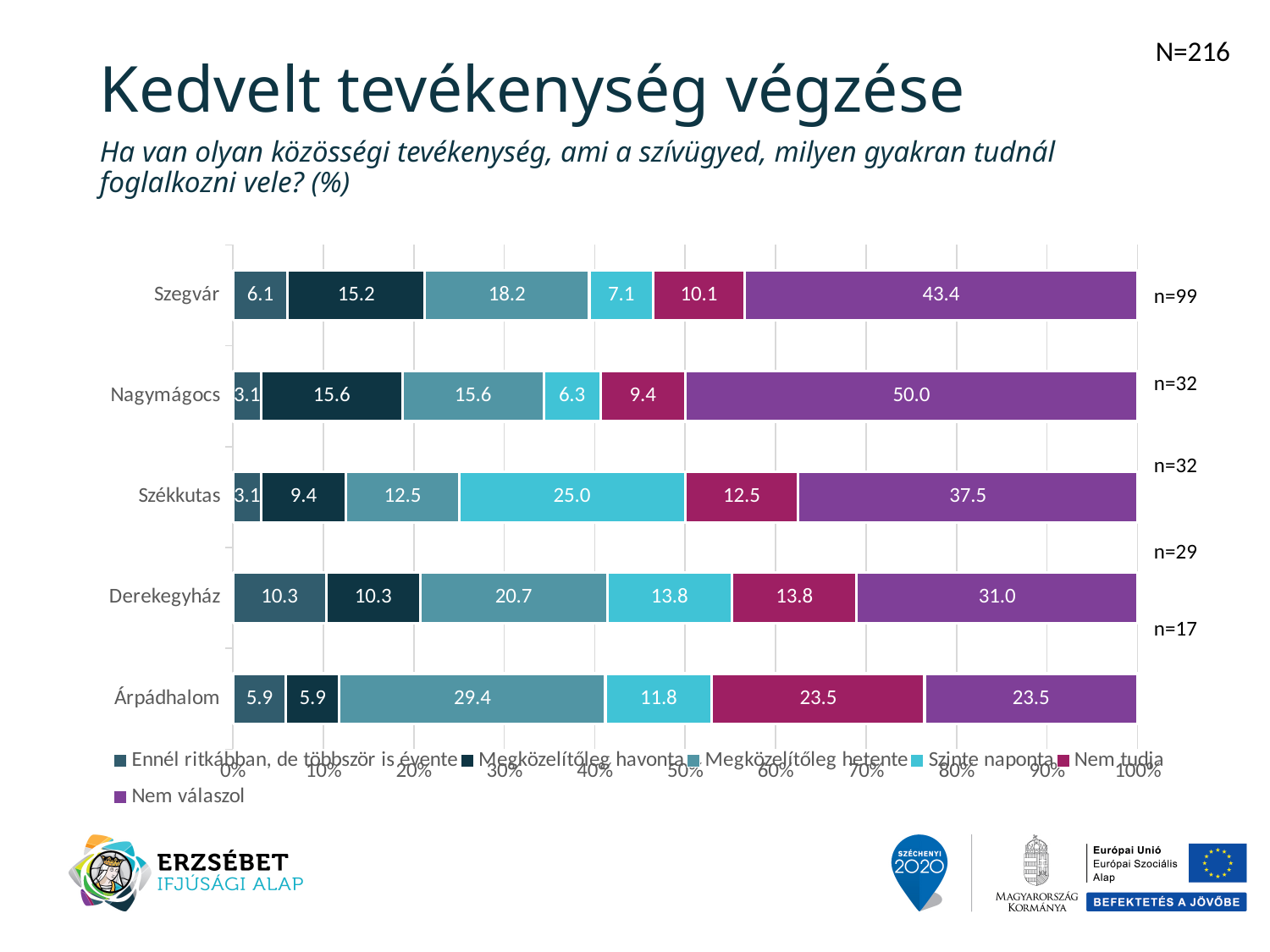
What is the difference between the 'Nem tudja' values for Árpádhalom and Szegvár? 13.4 What is the 'Szinte naponta' value for Székkutas? 25.0 Which settlement has the highest 'Nem válaszol' value? Nagymágocs Which is larger: the 'Megközelítőleg havonta' value for Szegvár or for Derekegyház? Szegvár What is the total N shown in the top right corner of the slide? N=216 What is the 'Megközelítőleg hetente' value for Árpádhalom? 29.4 How many settlements (categories) are shown on the chart? 5 What is the 'Nem válaszol' value for Nagymágocs? 50.0 Which settlement has the lowest 'Nem válaszol' value? Árpádhalom What is the sample size (n) shown for Szegvár? n=99 How many series does the legend list? 6 What kind of chart is shown on the slide? Stacked bar chart